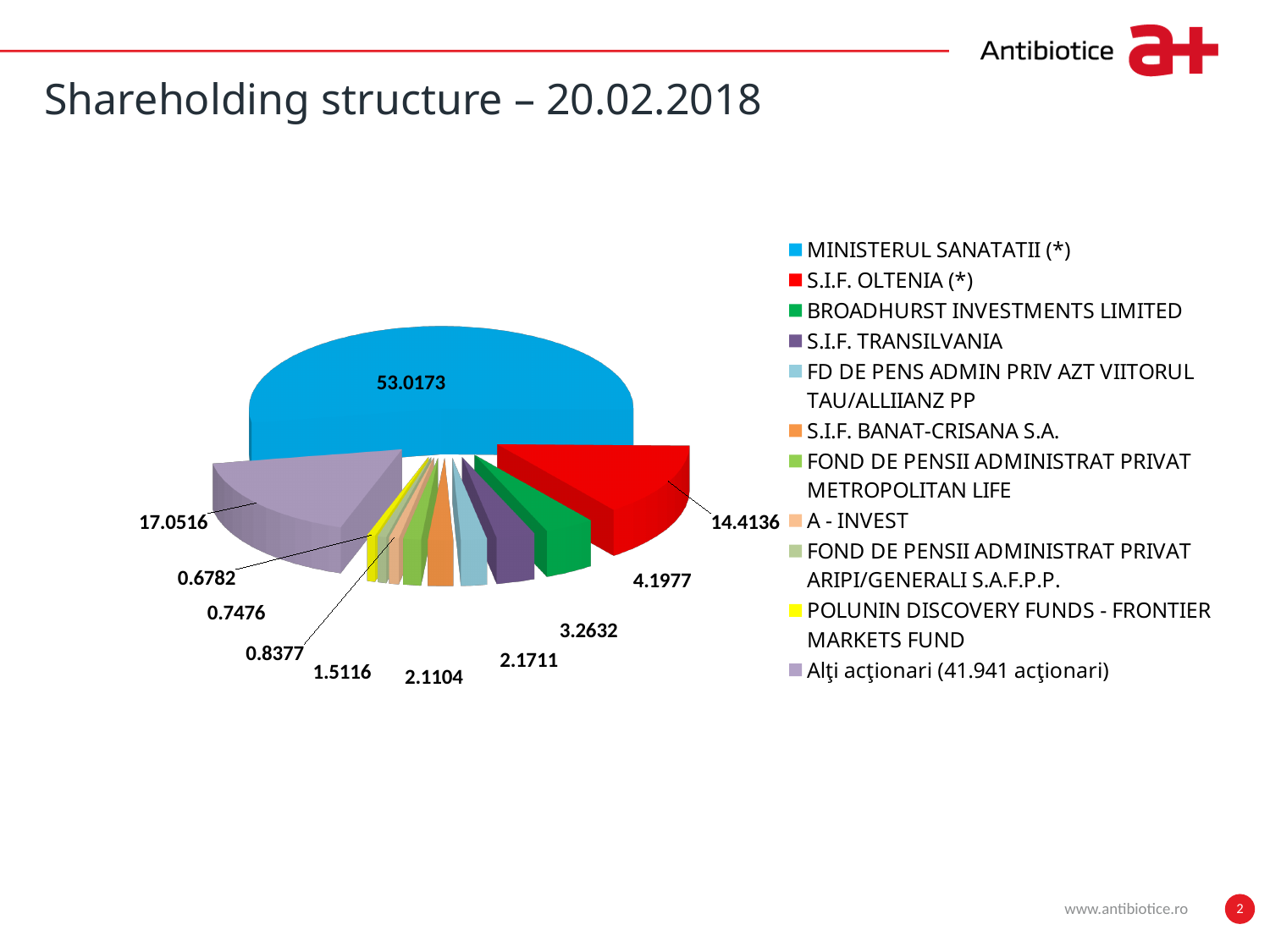
Which shareholder has the largest slice of the pie? MINISTERUL SANATATII (*) What is the value shown for Alţi acţionari (41.941 acţionari)? 17.0516 What is the value shown for MINISTERUL SANATATII (*)? 53.0173 What kind of chart is shown on the slide? pie chart Which shareholder has the smallest slice of the pie? POLUNIN DISCOVERY FUNDS - FRONTIER MARKETS FUND What is the title of the slide containing the chart? Shareholding structure – 20.02.2018 Which is larger, the value for Alţi acţionari (41.941 acţionari) or the value for S.I.F. OLTENIA (*)? Alţi acţionari (41.941 acţionari) How many entries does the legend list? 11 What is the value shown for S.I.F. OLTENIA (*)? 14.4136 What is the value shown for BROADHURST INVESTMENTS LIMITED? 4.1977 What is the value shown for S.I.F. TRANSILVANIA? 3.2632 What is the difference between the values for S.I.F. OLTENIA (*) and BROADHURST INVESTMENTS LIMITED? 10.2159